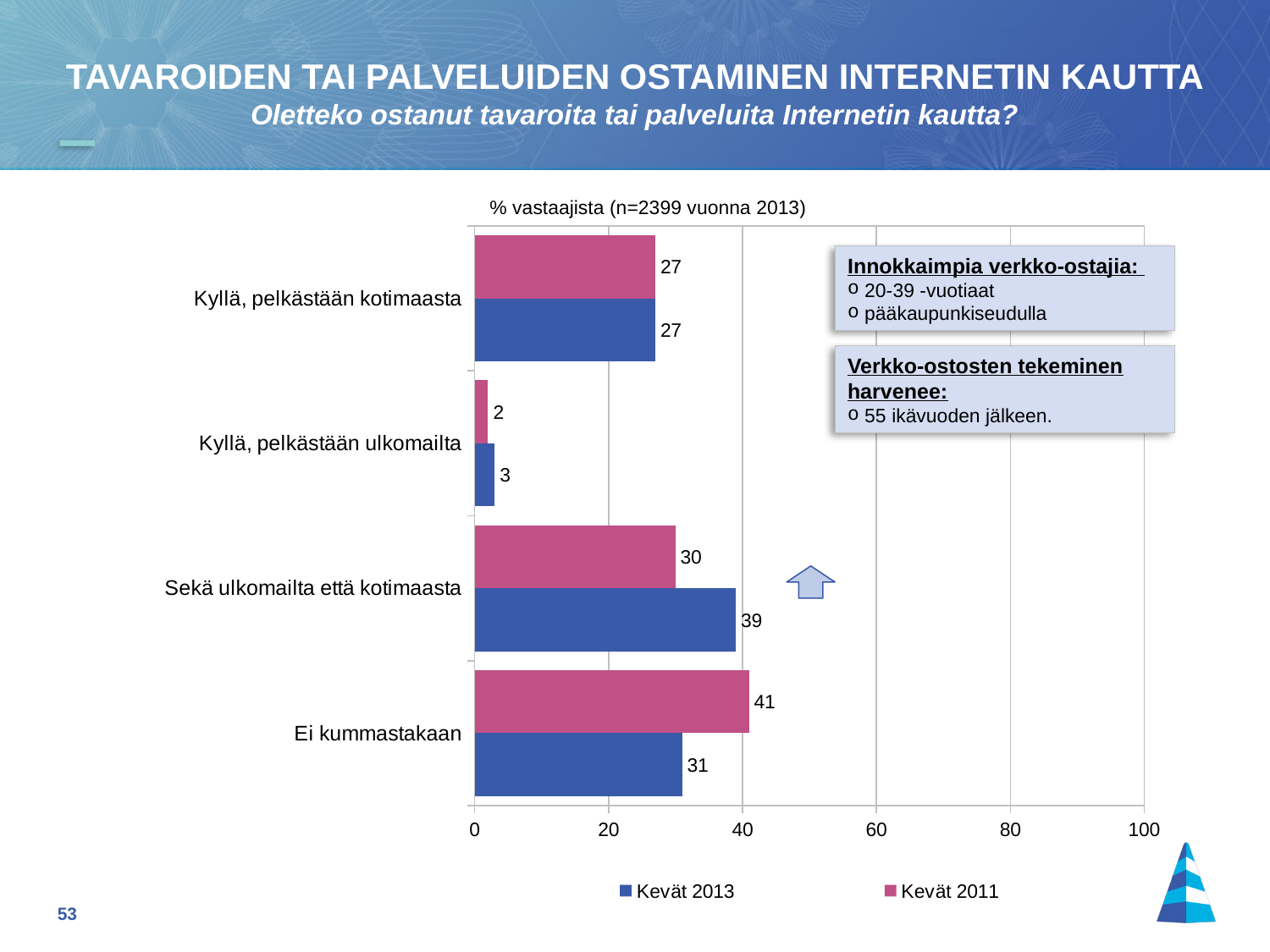
What is the difference between the Kevät 2011 and Kevät 2013 values for "Ei kummastakaan"? 10 What is the value for Kevät 2011 in the category "Kyllä, pelkästään ulkomailta"? 2 What is the value for Kevät 2011 in the category "Ei kummastakaan"? 41 What is the difference between the Kevät 2013 and Kevät 2011 values for "Sekä ulkomailta että kotimaasta"? 9 Which is larger for "Ei kummastakaan": the Kevät 2013 value or the Kevät 2011 value? Kevät 2011 What kind of chart is shown on the slide? Bar chart Which category has the highest value for Kevät 2013? Sekä ulkomailta että kotimaasta What is the value for Kevät 2013 in the category "Kyllä, pelkästään kotimaasta"? 27 How many series does the legend list? 2 Which category has the lowest value for Kevät 2011? Kyllä, pelkästään ulkomailta What is the value for Kevät 2013 in the category "Sekä ulkomailta että kotimaasta"? 39 How many categories are shown on the chart? 4